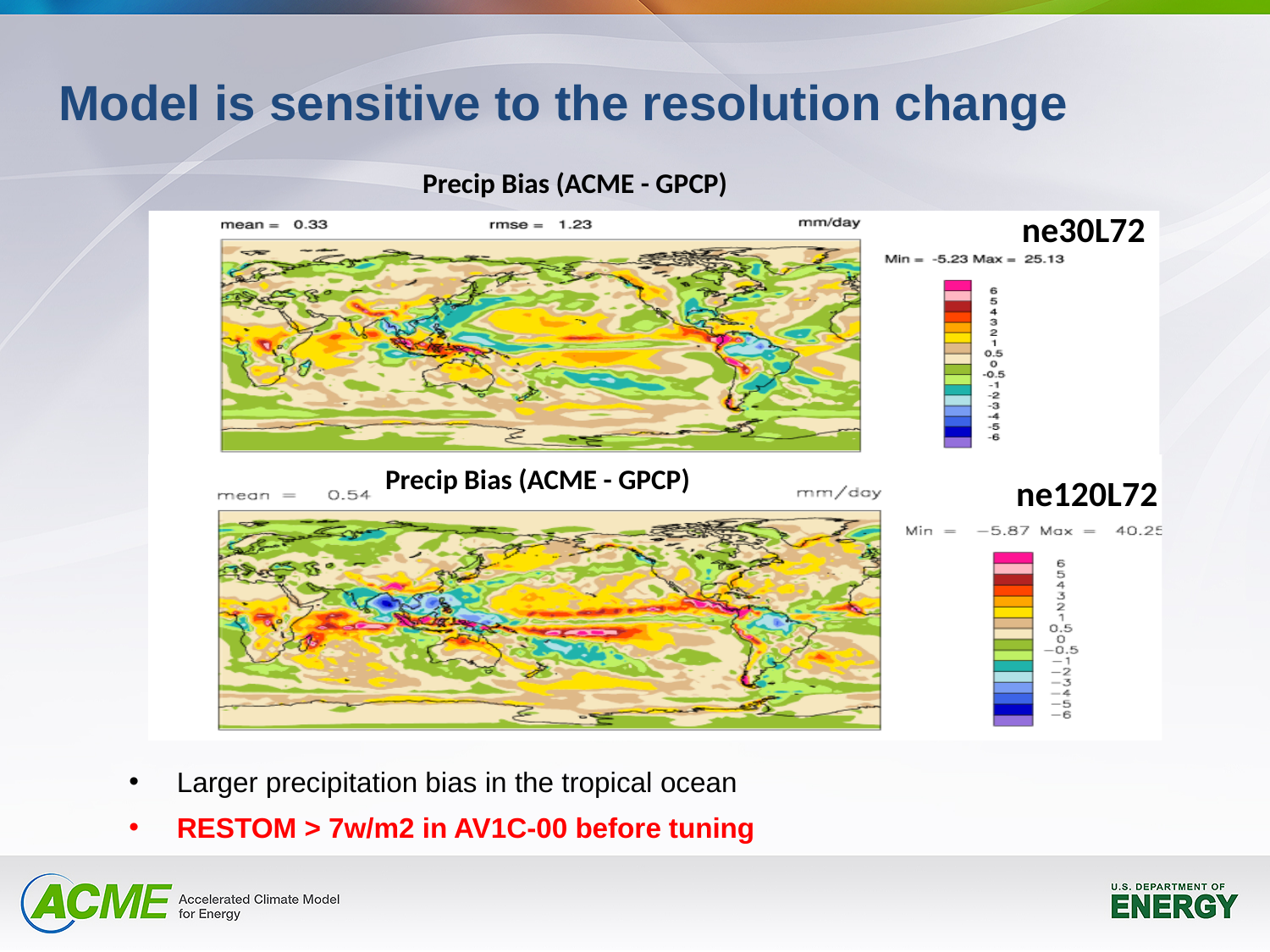
What is the difference between the printed Max values of the ne120L72 and ne30L72 charts? 15.12 On the bottom chart (ne120L72), what is the printed mean of the precipitation bias? 0.54 What kind of chart is used to show the precipitation bias on this slide? Map (filled contour map) Which chart has the larger printed mean bias, ne30L72 or ne120L72? ne120L72 On the top chart (ne30L72), what is the printed rmse value? 1.23 On the bottom chart (ne120L72), what is the printed Max value? 40.25 What is the difference between the printed mean values of the ne120L72 and ne30L72 charts? 0.21 On the bottom chart (ne120L72), what is the printed Min value? -5.87 On the top chart (ne30L72), what is the printed Max value? 25.13 How many precipitation bias charts are shown on the slide? 2 What unit is shown on both precipitation bias charts? mm/day On the top chart (ne30L72), what is the printed mean of the precipitation bias? 0.33